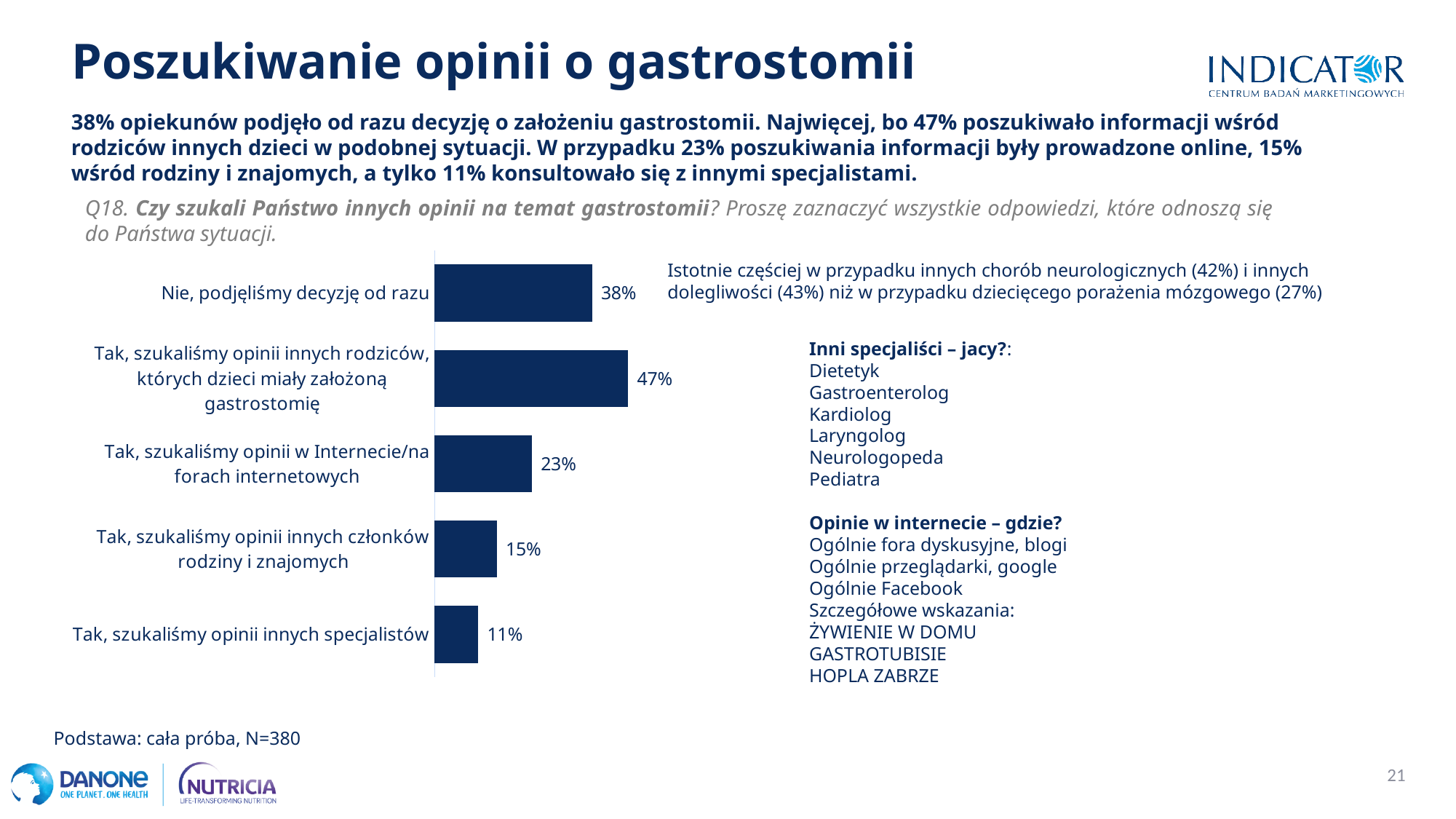
What is the value for "Tak, szukaliśmy opinii innych rodziców, których dzieci miały założoną gastrostomię"? 47% Which category has the lowest value in the chart? Tak, szukaliśmy opinii innych specjalistów What is the value for "Tak, szukaliśmy opinii innych specjalistów"? 11% Which category has the highest value in the chart? Tak, szukaliśmy opinii innych rodziców, których dzieci miały założoną gastrostomię How many categories are shown in the chart? 5 What is the difference between the value for seeking opinions of other parents (47%) and seeking opinions of other specialists (11%)? 36% Which is larger: the value for "Tak, szukaliśmy opinii innych członków rodziny i znajomych" or for "Tak, szukaliśmy opinii w Internecie/na forach internetowych"? Tak, szukaliśmy opinii w Internecie/na forach internetowych What percentage of respondents answered "Nie, podjęliśmy decyzję od razu"? 38% What is the difference between "Nie, podjęliśmy decyzję od razu" and "Tak, szukaliśmy opinii w Internecie/na forach internetowych"? 15% What percentage sought opinions on the Internet / internet forums ("Tak, szukaliśmy opinii w Internecie/na forach internetowych")? 23% What is the sample size (N) stated at the bottom of the slide? N=380 What type of chart is shown on the slide? Bar chart